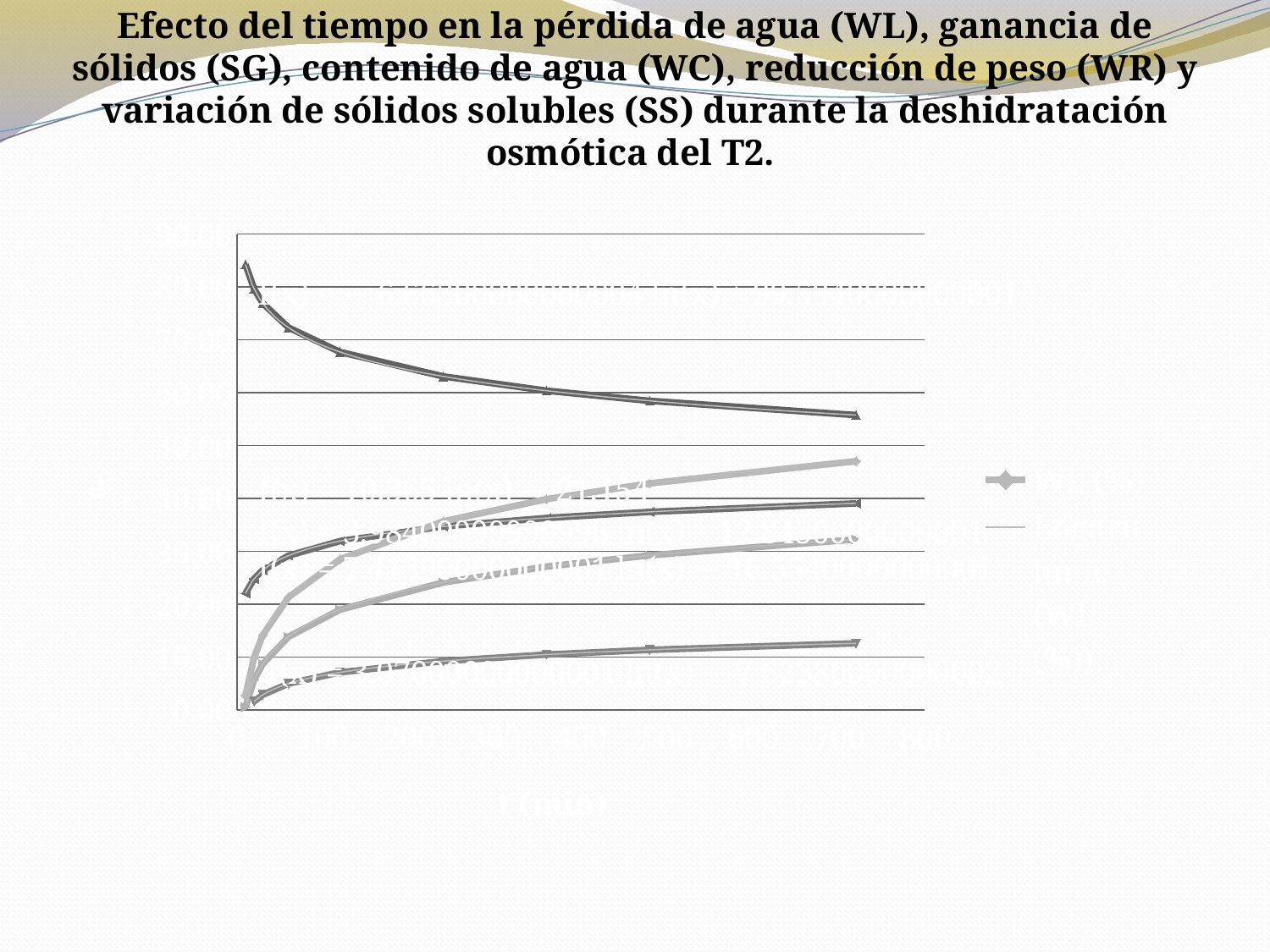
What is the highest value labelled on the y axis of the chart? 90.00 Is the value of the lowest line at its last point (around t = 700) greater or less than 20? less What is the title of the x axis of the chart? t (min) Is the value of the topmost line at its last point (around t = 700) greater or less than 50? greater Is the value of the topmost line at its last point (around t = 700) greater or less than 60? less What kind of chart is shown on the slide? line chart What is the largest tick value shown on the x axis of the chart? 800 Does the lowest line in the chart rise or fall as t (min) increases? rise Which series name is readable in the chart legend? WL (%) Does the topmost line in the chart rise or fall as t (min) increases? fall